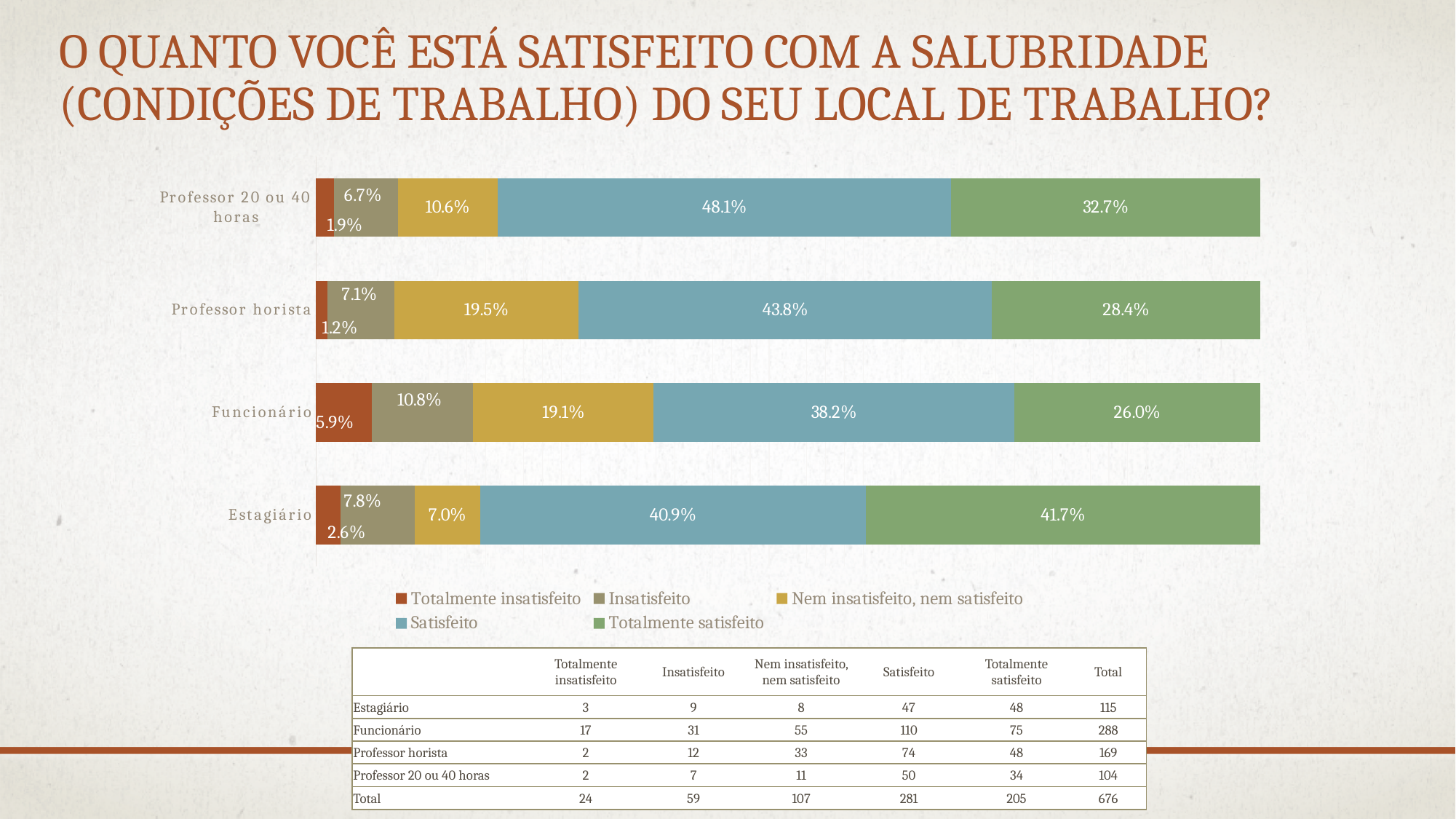
How many categories (bars) are shown in the chart? 4 What kind of chart is shown on the slide? Stacked bar chart What do the segments of the Estagiário bar add up to? 100.0% What is the Totalmente insatisfeito value for Funcionário? 5.9% How many series does the legend list? 5 What is the Nem insatisfeito, nem satisfeito value for Professor horista? 19.5% Which category has the highest Totalmente satisfeito share? Estagiário What is the Totalmente satisfeito value for Estagiário? 41.7% Which has a larger Totalmente satisfeito share, Professor 20 ou 40 horas or Professor horista? Professor 20 ou 40 horas How much higher is the Satisfeito share for Professor 20 ou 40 horas than for Professor horista? 4.3 percentage points Which category has the lowest Satisfeito share? Funcionário What percentage of Professor 20 ou 40 horas respondents answered Satisfeito? 48.1%